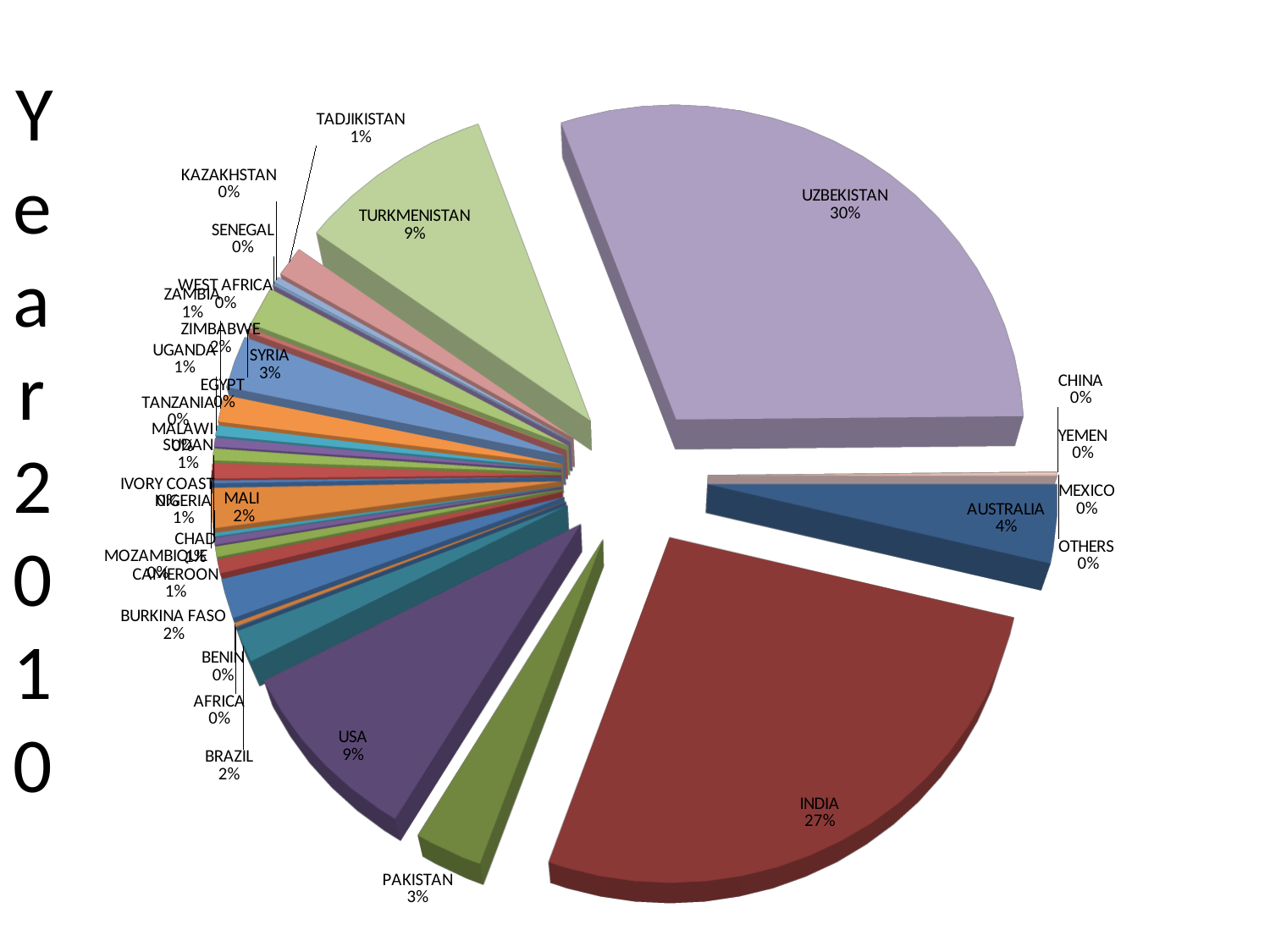
What is the difference in percentage points between UZBEKISTAN and INDIA? 3 percentage points Which country has the largest slice of the pie? UZBEKISTAN What year does the text on the left of the slide indicate the chart is for? 2010 What share of the pie does INDIA hold? 27% What kind of chart is shown on the slide? pie chart Which is larger, the share for USA or the share for AUSTRALIA? USA What percentage is shown for USA? 9% What percentage is shown for TURKMENISTAN? 9% What percentage is shown for AUSTRALIA? 4% What percentage is shown for TADJIKISTAN? 1% What percentage is shown for PAKISTAN? 3% What percentage is shown for BRAZIL? 2%